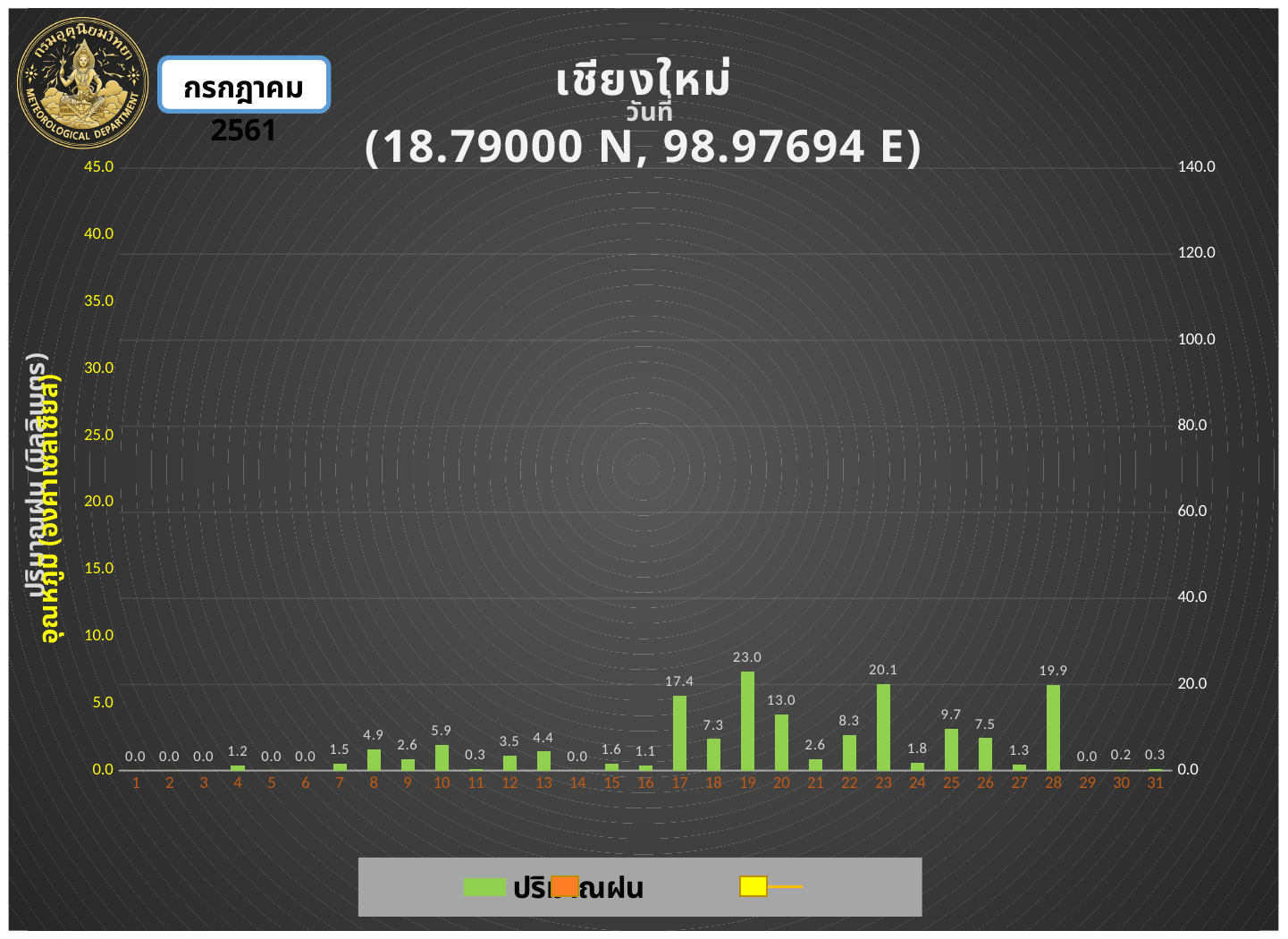
What is the rainfall value for day 10? 5.9 What coordinates are shown in the chart title? 18.79000 N, 98.97694 E Is the rainfall value for day 19 greater or less than 20.0 on the right axis? greater What is the rainfall value for day 19? 23.0 What kind of chart is shown on the slide? bar chart Which is larger, the rainfall value for day 20 or for day 22? day 20 Which day has the highest rainfall value? 19 What is the rainfall value for day 30? 0.2 What is the difference between the rainfall values for day 19 and day 28? 3.1 What is the difference between the rainfall values for day 23 and day 17? 2.7 What is the rainfall value for day 28? 19.9 How many days (categories) are shown on the x axis? 31